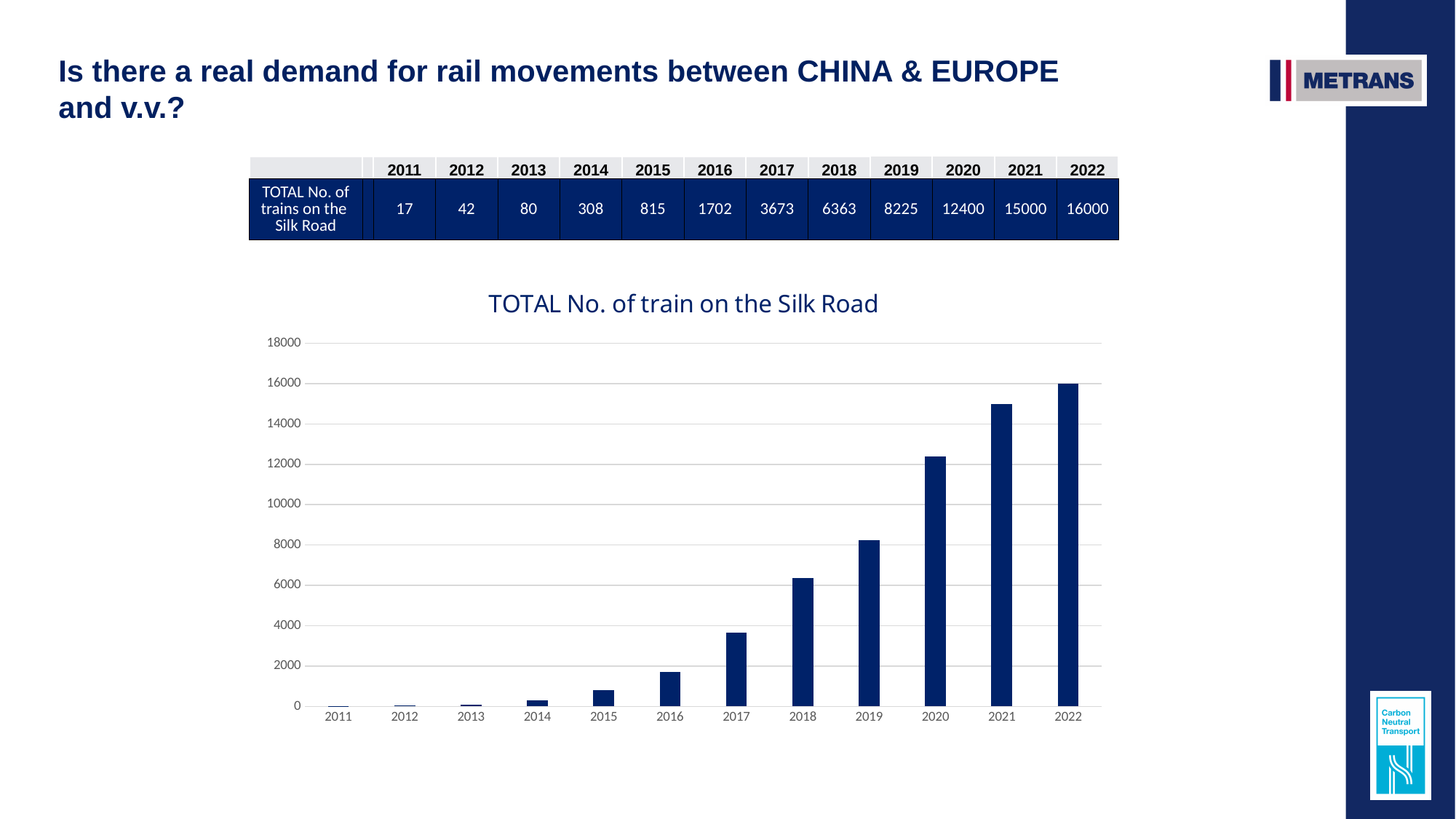
Do the values rise or fall from 2011 to 2022? rise What is the title of the chart? TOTAL No. of train on the Silk Road What is the total number of trains on the Silk Road in 2017? 3673 What type of chart is shown on the slide? bar chart How many years are plotted on the x axis of the chart? 12 What is the total number of trains on the Silk Road in 2022? 16000 Which year has the highest number of trains on the Silk Road? 2022 Which year has more trains on the Silk Road, 2018 or 2019? 2019 What is the total number of trains on the Silk Road in 2014? 308 Which year has the lowest number of trains on the Silk Road? 2011 Is the value for 2019 greater or less than 8000? greater What is the difference in the number of trains between 2021 and 2020? 2600